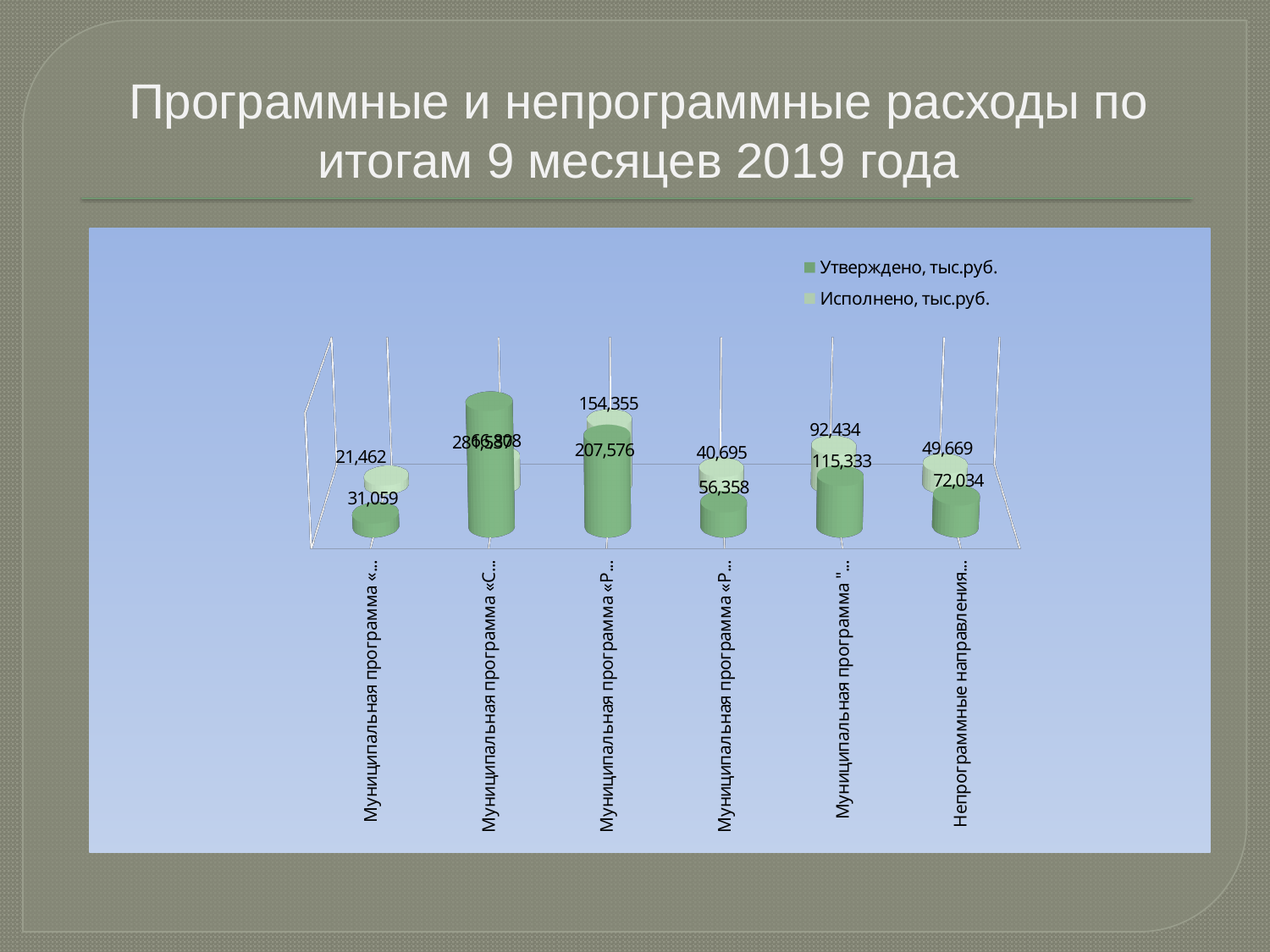
What type of chart is shown on the slide? Bar chart For 'Непрограммные направления…', what is the difference between the 'Утверждено' and 'Исполнено' values? 22,365 What is the 'Утверждено, тыс.руб.' value for 'Непрограммные направления…'? 72,034 For 'Непрограммные направления…', which is larger: the 'Утверждено' value or the 'Исполнено' value? Утверждено How many series does the chart legend list? 2 What is the 'Исполнено, тыс.руб.' value for the first category from the left? 21,462 What are the two series named in the chart legend? Утверждено, тыс.руб. and Исполнено, тыс.руб. What is the title of the slide containing the chart? Программные и непрограммные расходы по итогам 9 месяцев 2019 года What is the 'Исполнено, тыс.руб.' value for the third category from the left? 154,355 What is the 'Исполнено, тыс.руб.' value for 'Непрограммные направления…'? 49,669 What is the 'Утверждено, тыс.руб.' value for the third category from the left? 207,576 How many categories are plotted along the x axis of the chart? 6